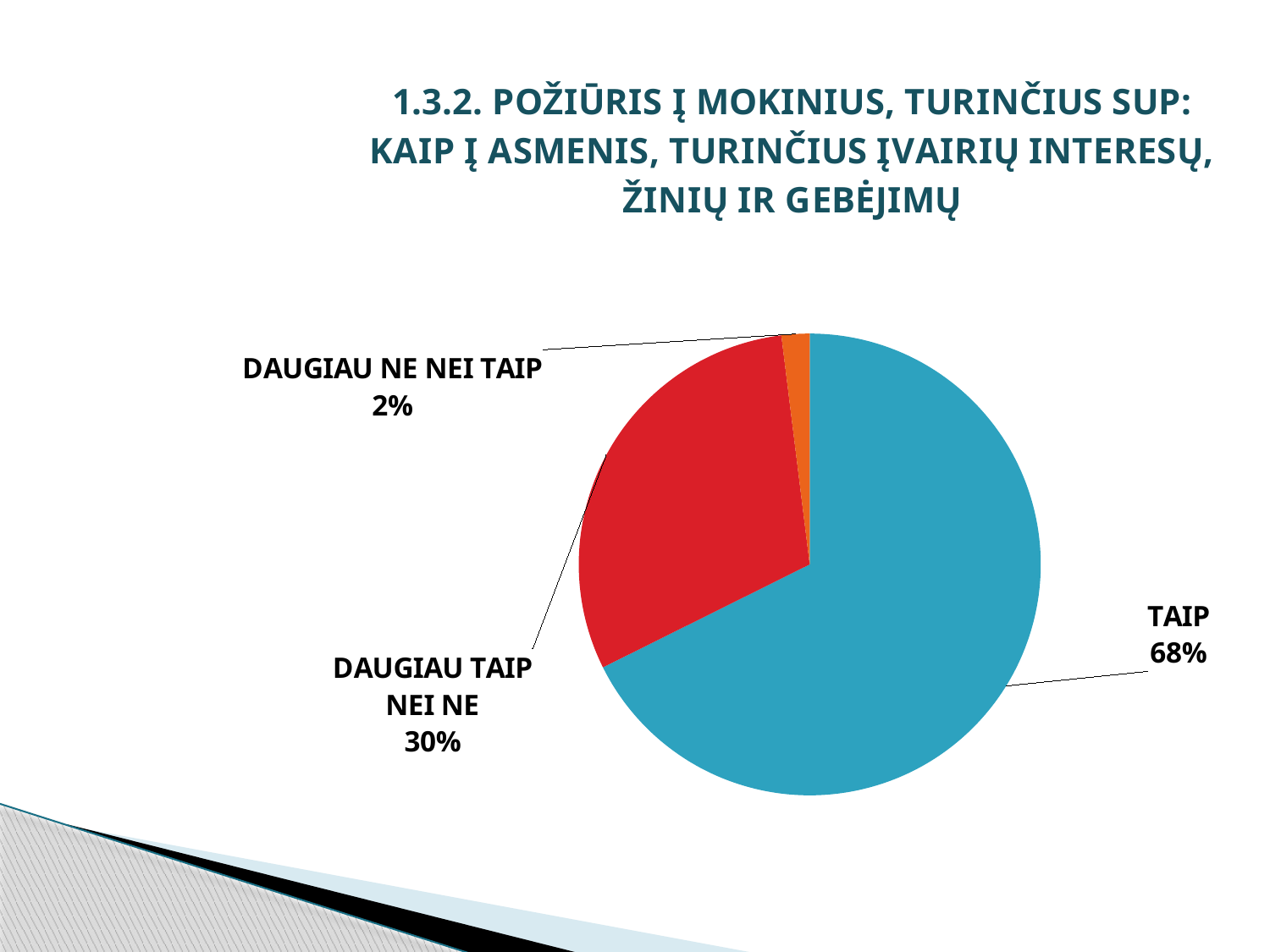
What colour is the DAUGIAU TAIP NEI NE slice? Red What share of the pie does the DAUGIAU TAIP NEI NE slice represent? 30% Which is larger, the TAIP slice or the DAUGIAU TAIP NEI NE slice? TAIP Which category has the smallest slice of the pie? DAUGIAU NE NEI TAIP What is the difference in percentage points between the TAIP slice and the DAUGIAU TAIP NEI NE slice? 38 What kind of chart is shown on the slide? Pie chart Which category has the largest slice of the pie? TAIP How many slices does the pie chart have? 3 What is the difference in percentage points between the DAUGIAU TAIP NEI NE slice and the DAUGIAU NE NEI TAIP slice? 28 What colour is the TAIP slice? Blue What share of the pie does the TAIP slice represent? 68% What share of the pie does the DAUGIAU NE NEI TAIP slice represent? 2%